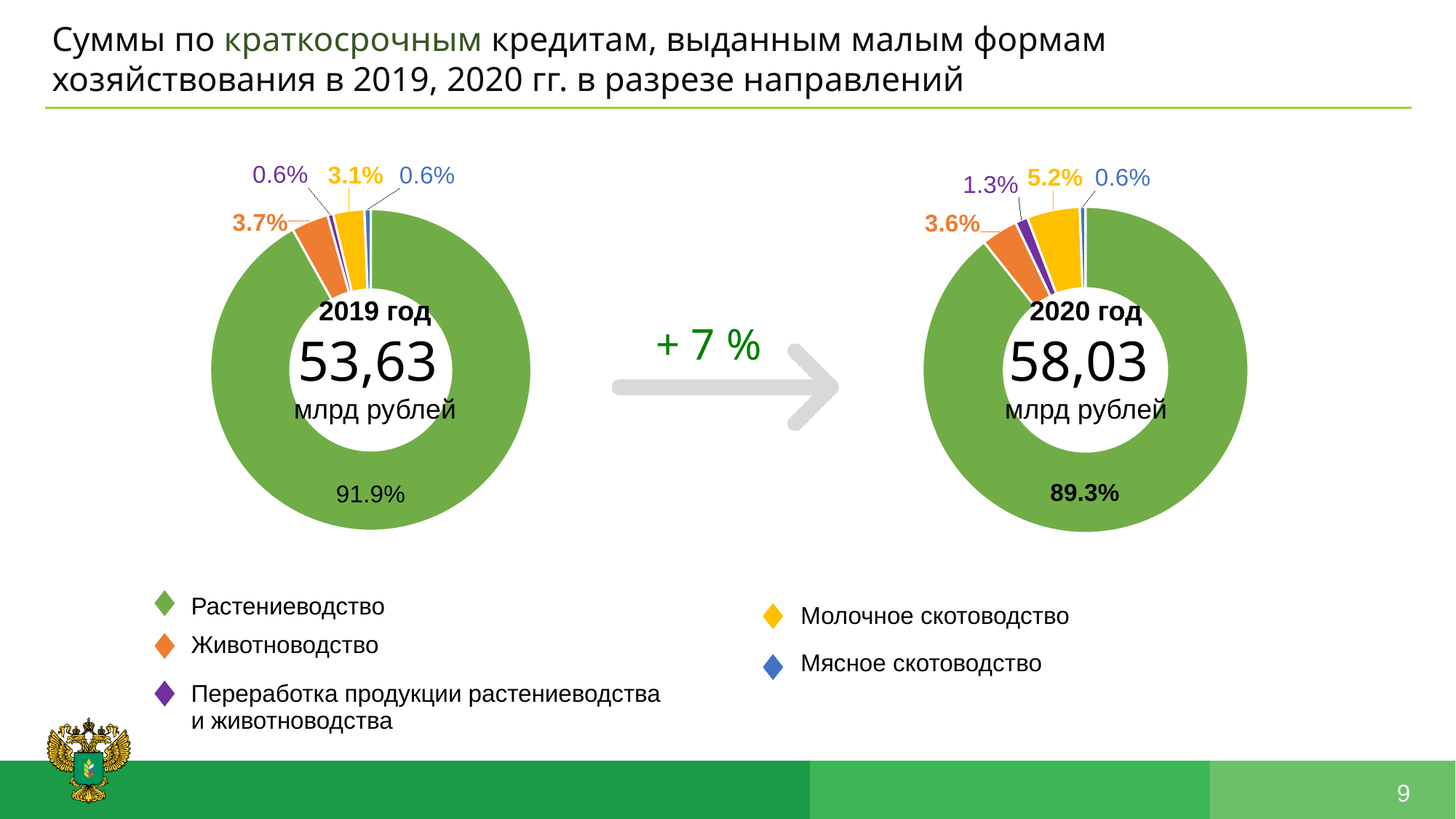
What is the difference between the share of Растениеводство in the 2019 год chart and in the 2020 год chart? 2.6% What type of chart is used for the 2019 год and 2020 год data? Donut (pie) chart In the 2020 год chart, which category has the largest share? Растениеводство What total value is shown in the centre of the 2020 год chart? 58,03 млрд рублей How many categories does the legend list? 5 What total value is shown in the centre of the 2019 год chart? 53,63 млрд рублей In the 2020 год chart, which category has the smallest share? Мясное скотоводство In the 2020 год chart, what share does Молочное скотоводство have? 5.2% In the 2019 год chart, what share does Растениеводство have? 91.9% In the 2019 год chart, which is larger: the share of Животноводство or the share of Молочное скотоводство? Животноводство In the 2020 год chart, what share does Переработка продукции растениеводства и животноводства have? 1.3% In the 2019 год chart, what share does Животноводство have? 3.7%